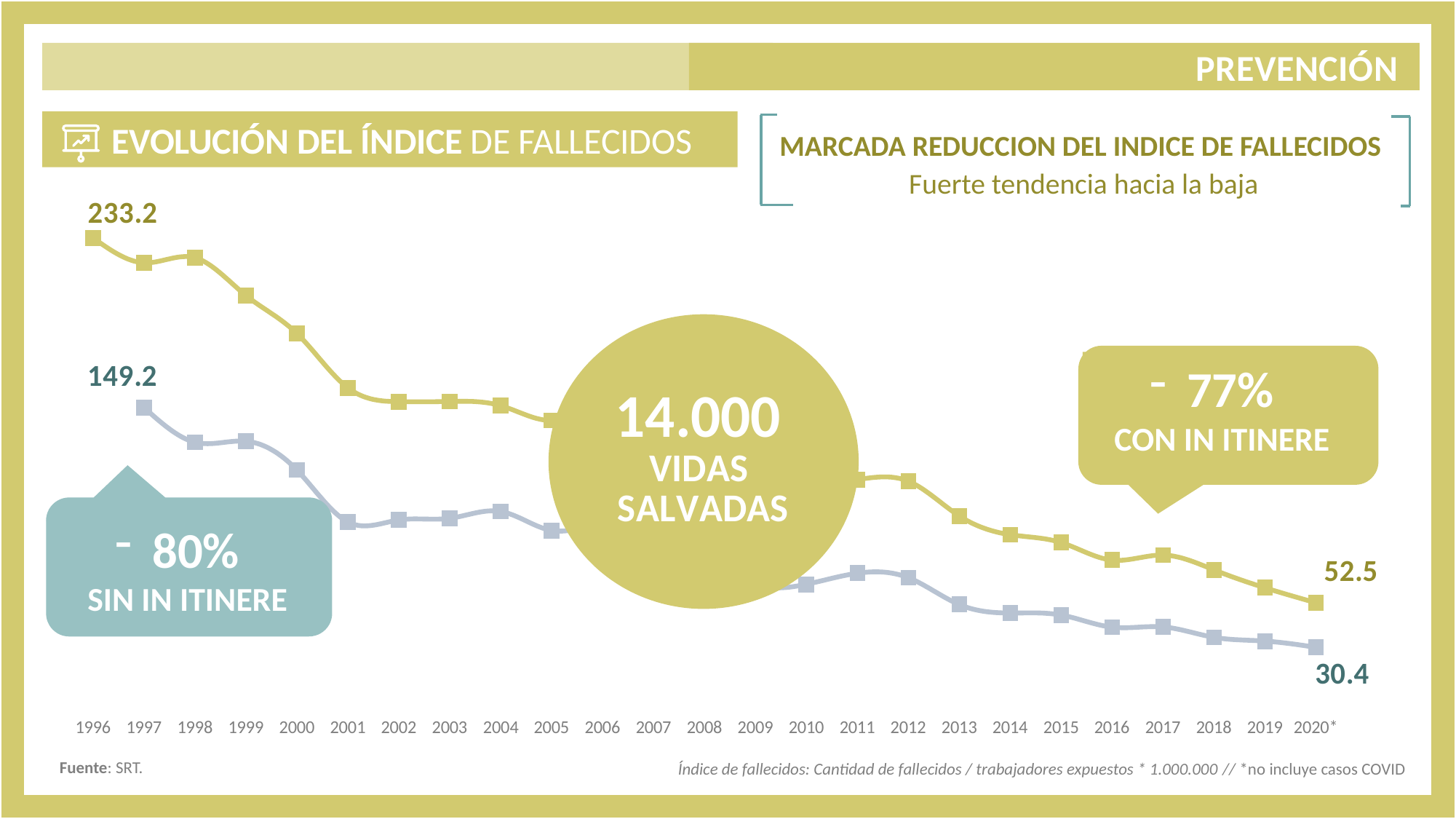
What kind of chart is shown on the slide? Line chart What is the value of the lower (grey-blue) line in 2020*? 30.4 What is the difference between the lower (grey-blue) line's 1997 value and its 2020* value? 118.8 Do the values of the lines rise or fall from 1996 to 2020*? Fall By how much did the upper (yellow) line fall from its 1996 value of 233.2 to its 2020* value of 52.5? 180.7 What is the value of the upper (yellow) line in 1996? 233.2 How many years are shown on the x axis? 25 What percentage reduction does the callout give for 'SIN IN ITINERE'? -80% In which year does the upper (yellow) line reach its highest value? 1996 In 2020*, which line has the higher value, the yellow line or the grey-blue line? The yellow line What is the value of the upper (yellow) line in 2020*? 52.5 What is the value of the lower (grey-blue) line in 1997? 149.2